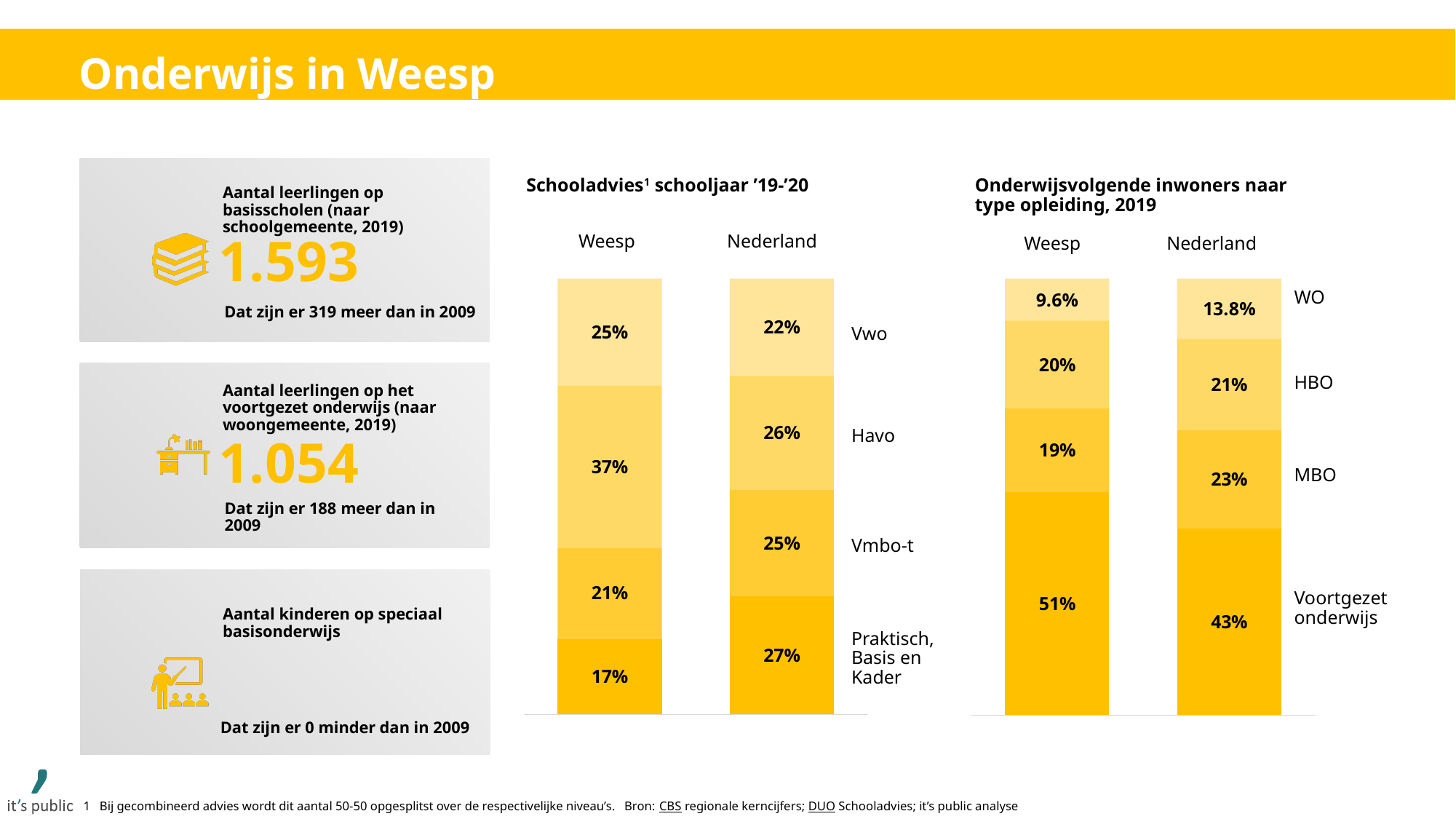
In the 'Schooladvies schooljaar '19-'20' chart, what is the difference between the Vwo share for Weesp and for Nederland? 3% In the 'Schooladvies schooljaar '19-'20' chart, what percentage of the Nederland bar is Praktisch, Basis en Kader? 27% What kind of chart is the 'Onderwijsvolgende inwoners naar type opleiding, 2019' chart? Stacked bar chart In the 'Onderwijsvolgende inwoners naar type opleiding, 2019' chart, which segment of the Nederland bar is the largest? Voortgezet onderwijs In the 'Onderwijsvolgende inwoners naar type opleiding, 2019' chart, how many education types are stacked in each bar? 4 In the 'Schooladvies schooljaar '19-'20' chart, which segment of the Weesp bar is the smallest? Praktisch, Basis en Kader In the 'Schooladvies schooljaar '19-'20' chart, what percentage of the Weesp bar is Havo? 37% In the 'Onderwijsvolgende inwoners naar type opleiding, 2019' chart, what percentage of the Weesp bar is Voortgezet onderwijs? 51% In the 'Onderwijsvolgende inwoners naar type opleiding, 2019' chart, what is the difference between the Voortgezet onderwijs share for Weesp and for Nederland? 8% In the 'Schooladvies schooljaar '19-'20' chart, how many bars are shown? 2 In the 'Schooladvies schooljaar '19-'20' chart, which has a larger Vmbo-t share, Weesp or Nederland? Nederland In the 'Onderwijsvolgende inwoners naar type opleiding, 2019' chart, what percentage of the Nederland bar is WO? 13.8%